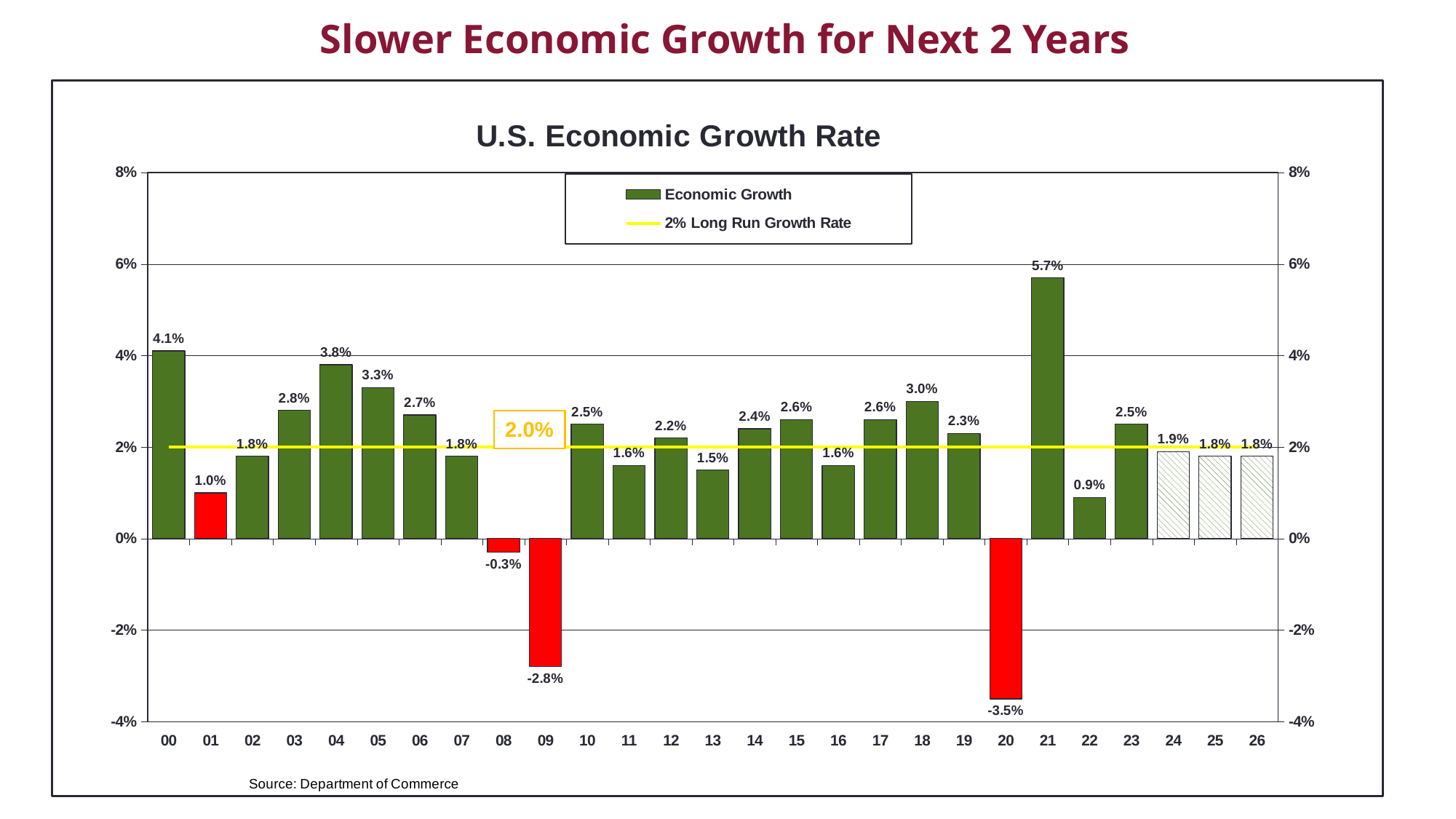
What value does the yellow horizontal line represent? 2.0% Which year has the lowest economic growth rate? 20 What kind of chart is this? combination bar and line chart What is the U.S. economic growth rate shown for 21? 5.7% How many entries does the legend list? 2 What is the difference between the growth rate in 21 and the growth rate in 22? 4.8% Which year has the highest economic growth rate? 21 Which year has a higher growth rate, 04 or 05? 04 What is the economic growth rate shown for 24? 1.9% What is the title of the chart? U.S. Economic Growth Rate What is the economic growth rate shown for 09? -2.8% How many years are shown on the x axis? 27